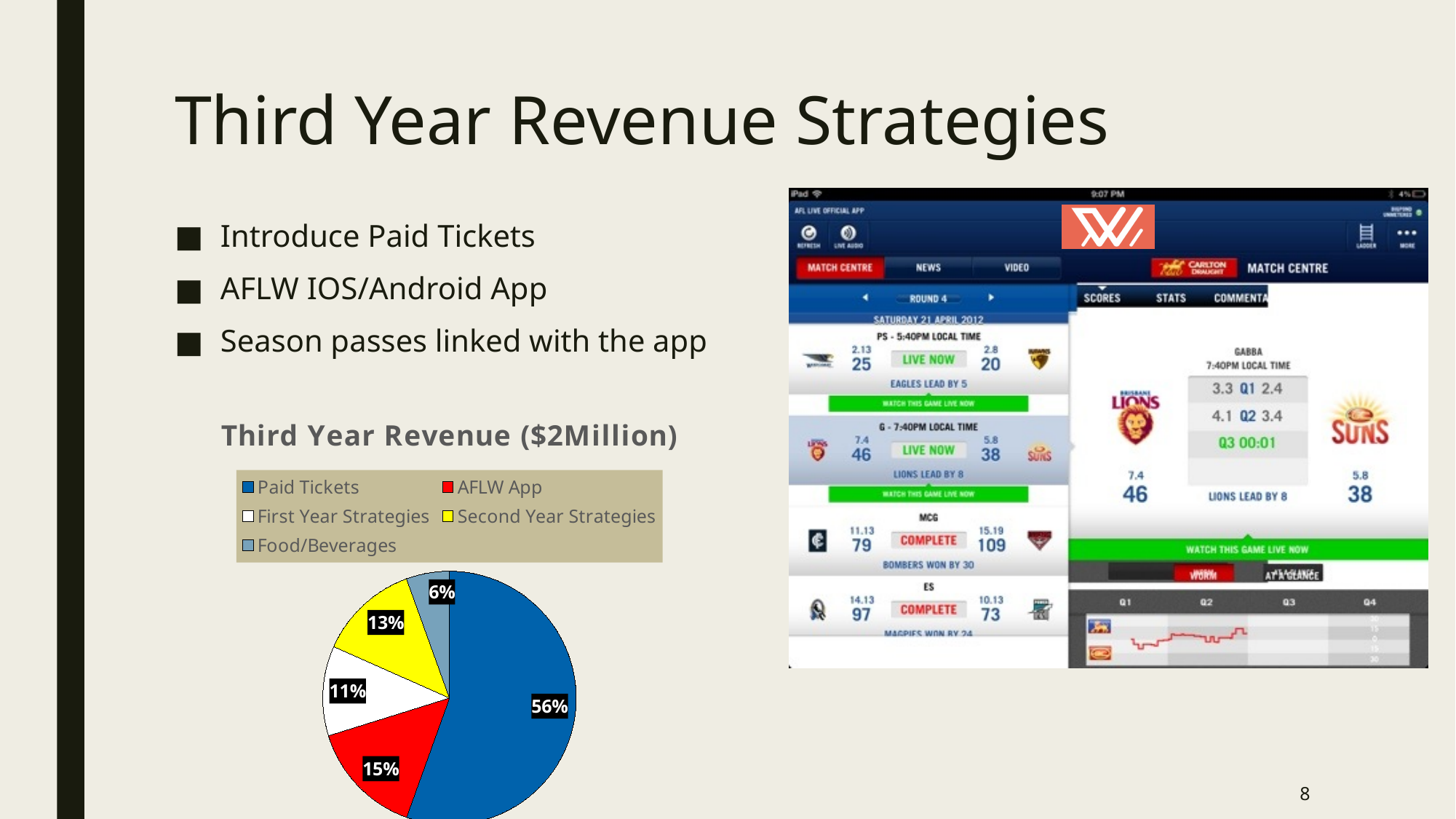
What is the title of the chart? Third Year Revenue ($2Million) What share of the pie does AFLW App take? 15% What share of the pie does Second Year Strategies take? 13% What share of the pie does Paid Tickets take? 56% Which category has the smallest slice of the pie? Food/Beverages Which category has the largest slice of the pie? Paid Tickets How many categories does the pie chart have? 5 What is the difference in percentage points between the Paid Tickets slice and the AFLW App slice? 41 What kind of chart is shown on the slide? pie chart Which slice is larger, Second Year Strategies or First Year Strategies? Second Year Strategies